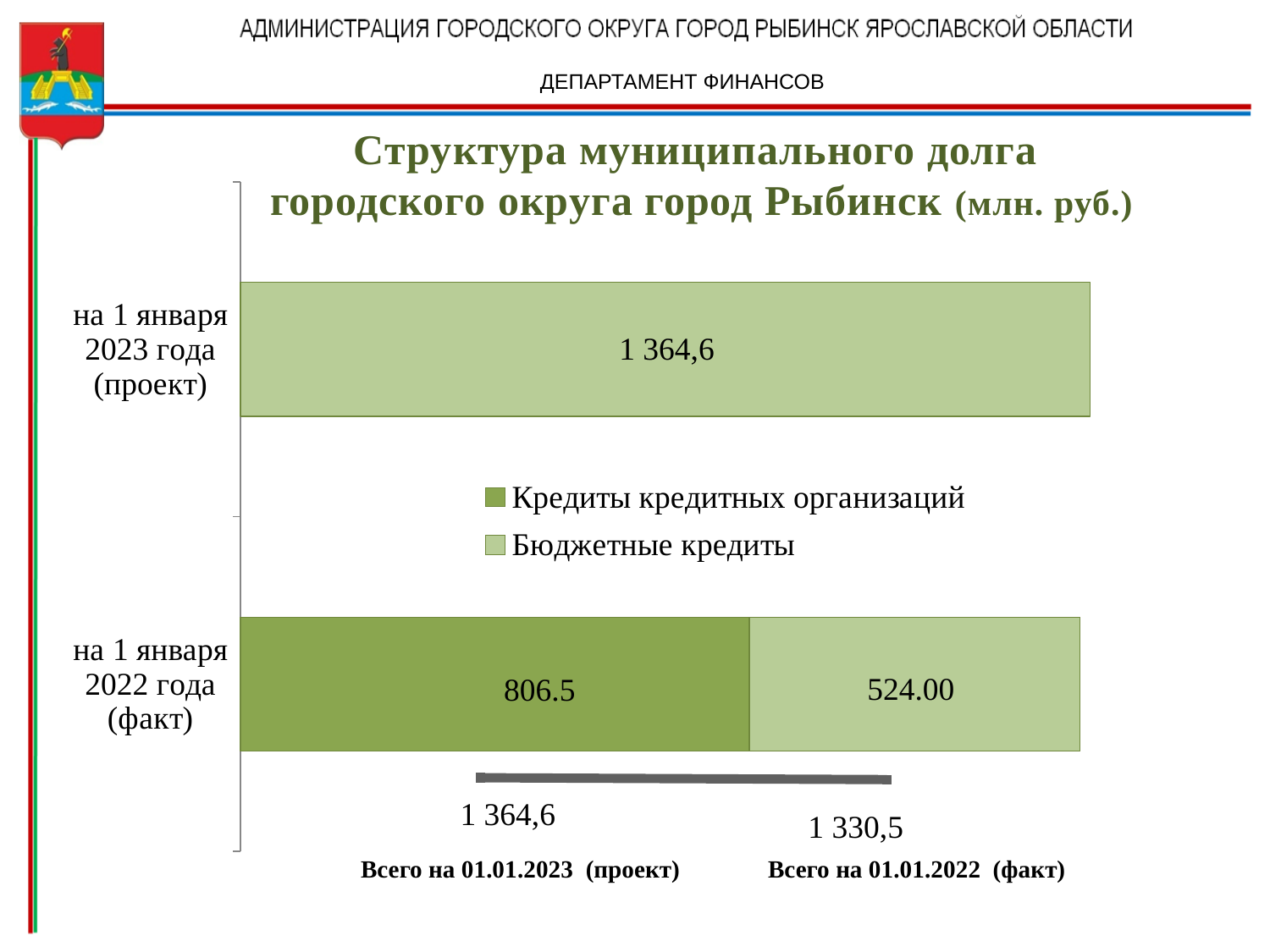
What are the two legend entries of the chart? Кредиты кредитных организаций; Бюджетные кредиты What kind of chart is shown on the slide? bar chart What is the value of "Бюджетные кредиты" for "на 1 января 2022 года (факт)"? 524.00 For "на 1 января 2022 года (факт)", which is larger: "Кредиты кредитных организаций" or "Бюджетные кредиты"? Кредиты кредитных организаций What is the value of "Кредиты кредитных организаций" for "на 1 января 2022 года (факт)"? 806.5 For "на 1 января 2022 года (факт)", what is the difference between "Кредиты кредитных организаций" and "Бюджетные кредиты"? 282.5 What is the total municipal debt shown for 01.01.2022 (факт)? 1 330,5 What is the difference between the total on 01.01.2023 (проект) and the total on 01.01.2022 (факт)? 34,1 How many series does the legend list? 2 How many categories (dates) are shown on the chart? 2 What is the total municipal debt shown for 01.01.2023 (проект)? 1 364,6 What value is printed on the bar for "на 1 января 2023 года (проект)"? 1 364,6